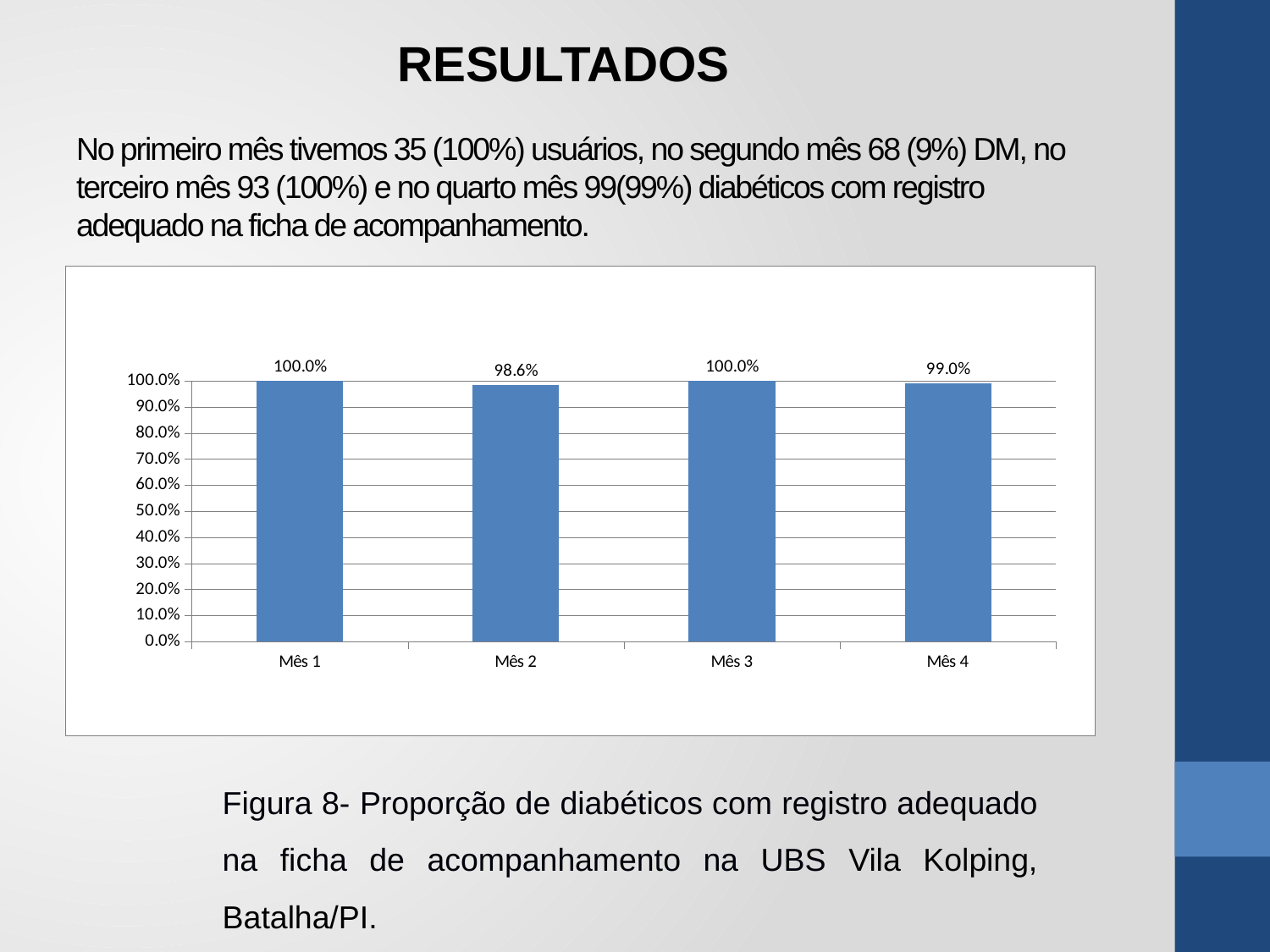
What is the value for Mês 1? 100.0% What kind of chart is shown on the slide? bar chart What is the difference between the values for Mês 1 and Mês 2? 1.4% Which is larger, the value for Mês 2 or the value for Mês 4? Mês 4 How many months are shown on the x axis? 4 What is the value for Mês 4? 99.0% Is the value for Mês 2 greater or less than 90.0%? greater What is the value for Mês 3? 100.0% Which month has the lowest value? Mês 2 What is the difference between the values for Mês 4 and Mês 2? 0.4% What is the value for Mês 2? 98.6% Does the value rise or fall from Mês 1 to Mês 2? fall